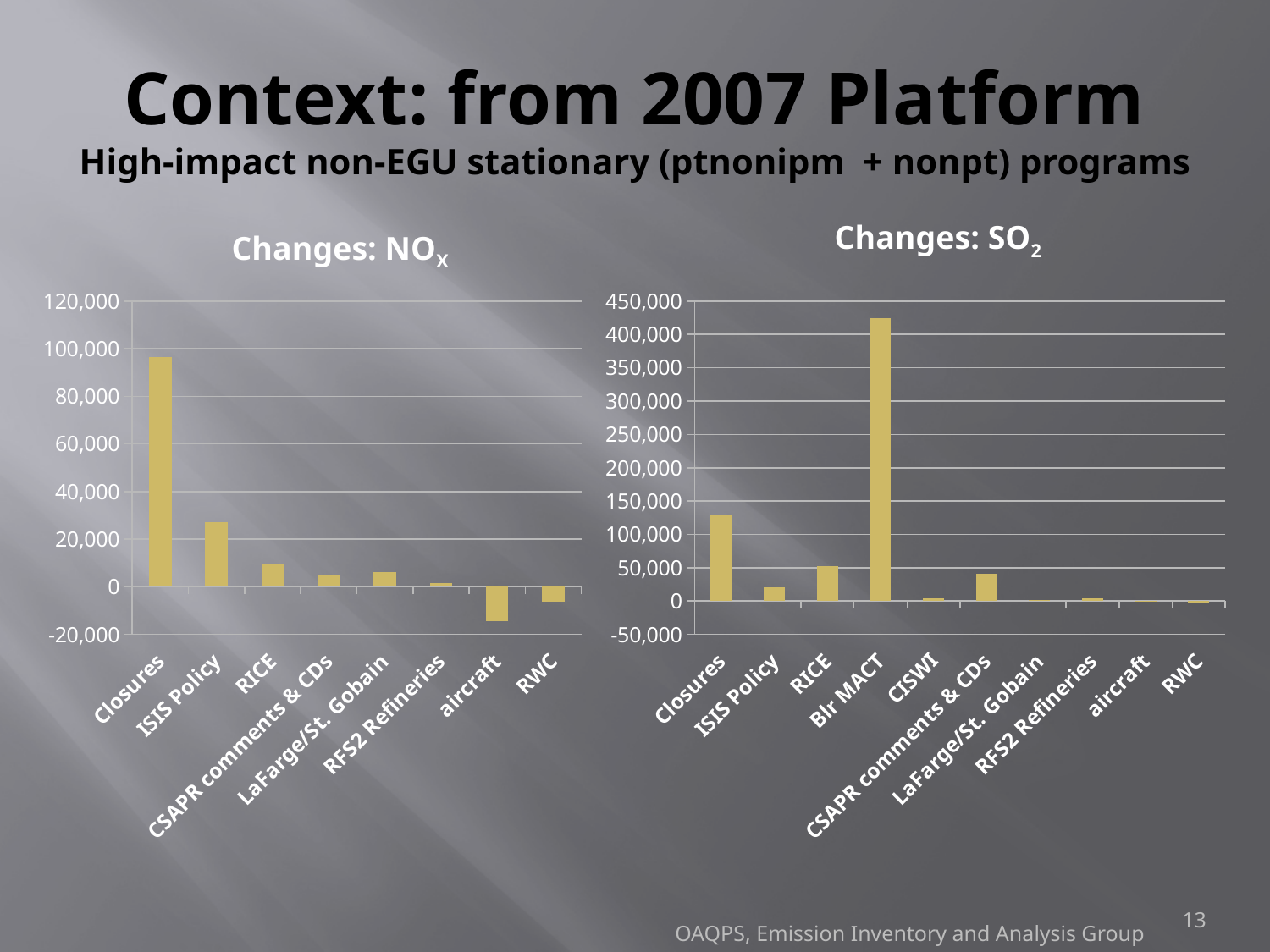
In the Changes: NOx chart, which category has the lowest value? aircraft In the Changes: SO2 chart, which category has the highest value? Blr MACT In the Changes: SO2 chart, is the value for CSAPR comments & CDs greater or less than 50,000? less In the Changes: NOx chart, is the value for Closures greater or less than 80,000? greater In the Changes: NOx chart, which category has the highest value? Closures In the Changes: SO2 chart, which is larger, the value for Closures or the value for RICE? Closures In the Changes: SO2 chart, is the value for Closures greater or less than 100,000? greater What kind of chart is the Changes: NOx chart? bar chart How many categories are shown in the Changes: SO2 chart? 10